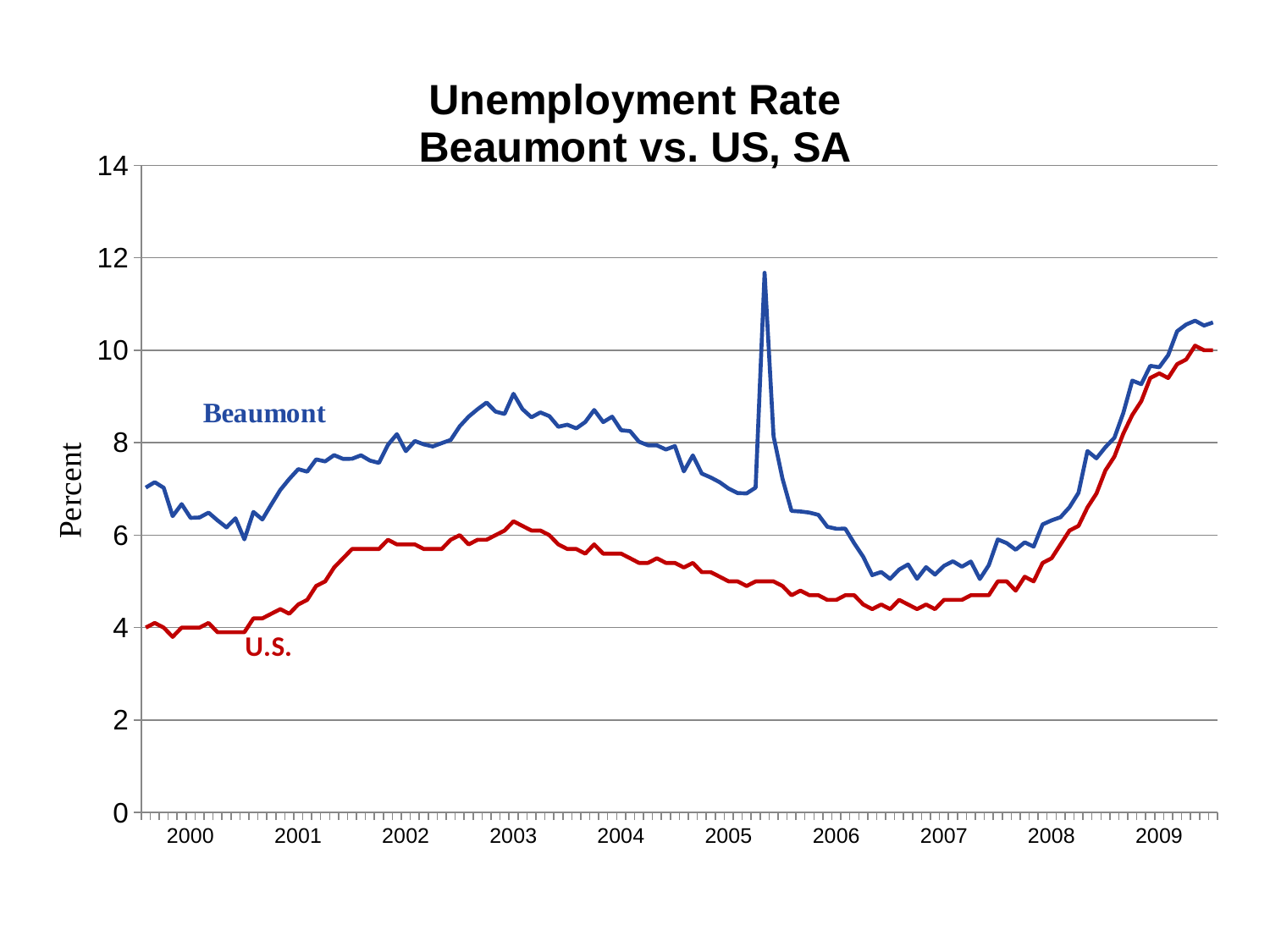
Which series is drawn in blue? Beaumont How many years are labeled on the horizontal axis? 10 Is the peak value of the Beaumont series in 2005 greater or less than 10? greater Is the value for U.S. at the start of 2000 greater or less than 6? less Does the U.S. unemployment rate rise or fall from 2008 to 2009? rise What is the title of the chart? Unemployment Rate Beaumont vs. US, SA What is the label on the vertical axis? Percent Is the value for U.S. at the start of 2007 greater or less than 6? less Which series has the higher unemployment rate in 2006, Beaumont or U.S.? Beaumont What kind of chart is shown on the slide? line chart How many series are plotted on the chart? 2